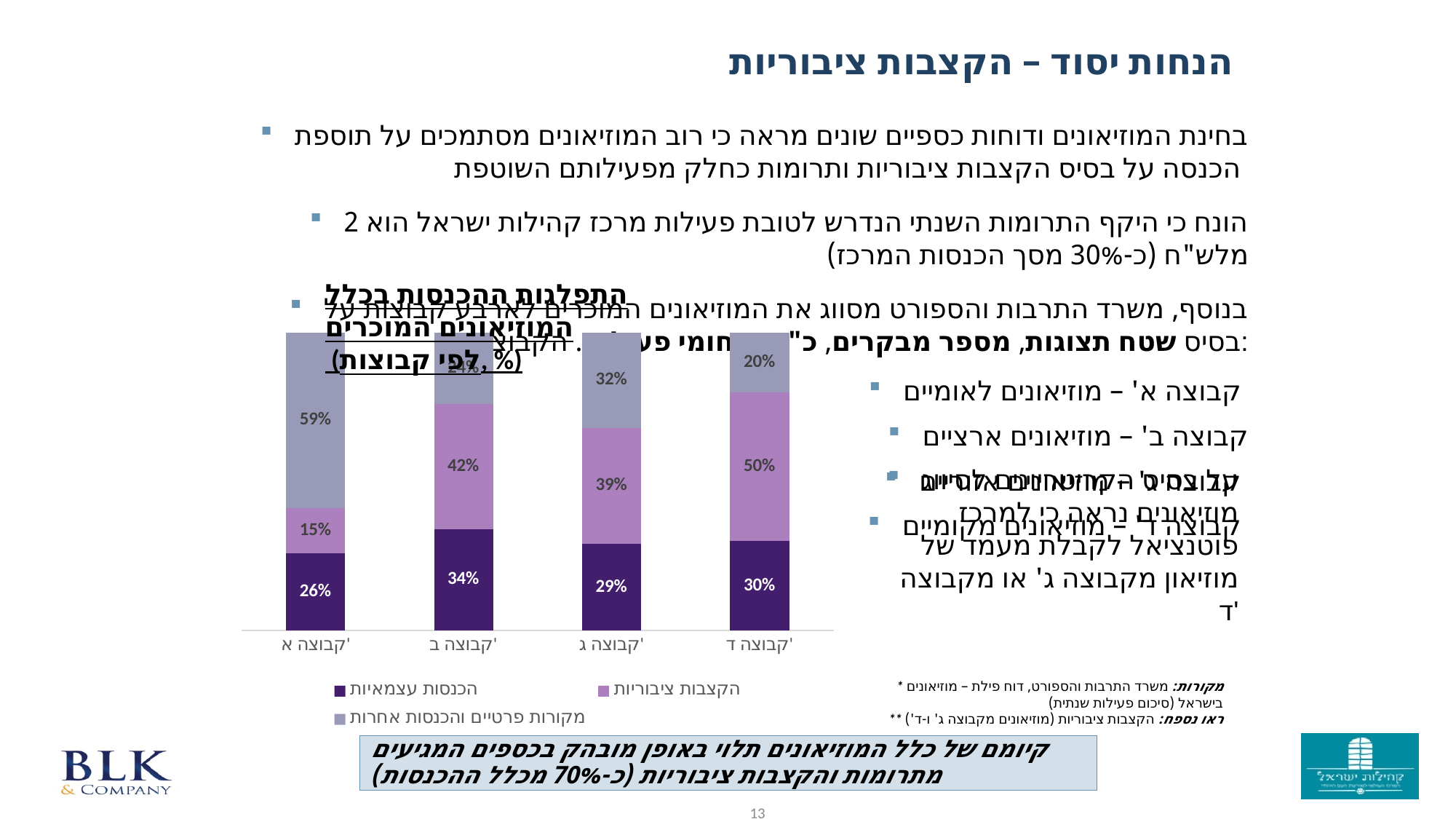
Which group has the lowest value for הקצבות ציבוריות? קבוצה א' Which series is shown in the darkest purple colour at the bottom of each bar? הכנסות עצמאיות What is the difference between the הקצבות ציבוריות values for קבוצה ד' and קבוצה א'? 35% What is the value of הקצבות ציבוריות for קבוצה ד'? 50% Which is larger: מקורות פרטיים והכנסות אחרות for קבוצה ג' or for קבוצה ד'? קבוצה ג' What is the value of הכנסות עצמאיות for קבוצה א'? 26% What is the value of מקורות פרטיים והכנסות אחרות for קבוצה א'? 59% What is the value of הקצבות ציבוריות for קבוצה ג'? 39% Which group has the highest value for הכנסות עצמאיות? קבוצה ב' How many categories (groups) are shown on the x axis of the chart? 4 How many series does the chart legend list? 3 What type of chart is shown on the slide? stacked bar chart